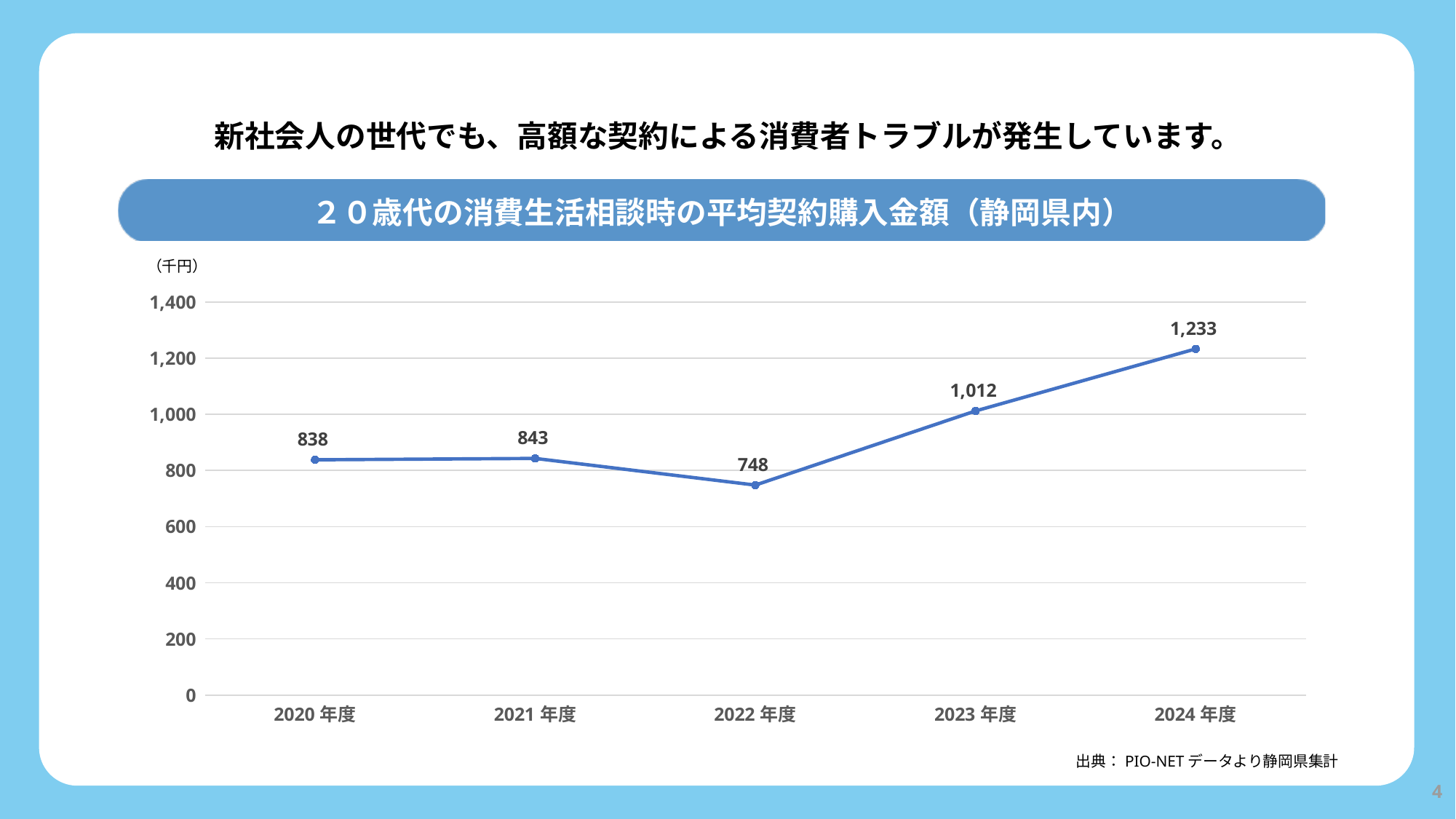
Which is larger, the value for 2023年度 or the value for 2021年度? 2023年度 How many years are plotted on the chart? 5 What unit is shown on the vertical axis? 千円 What is the value for 2024年度? 1,233 Which year has the lowest value? 2022年度 What is the difference between the values for 2021年度 and 2022年度? 95 What is the value for 2022年度? 748 Is the value for 2023年度 greater or less than 1,000? greater Which year has the highest value? 2024年度 What is the difference between the values for 2024年度 and 2023年度? 221 What is the value for 2020年度? 838 What kind of chart is shown? line chart